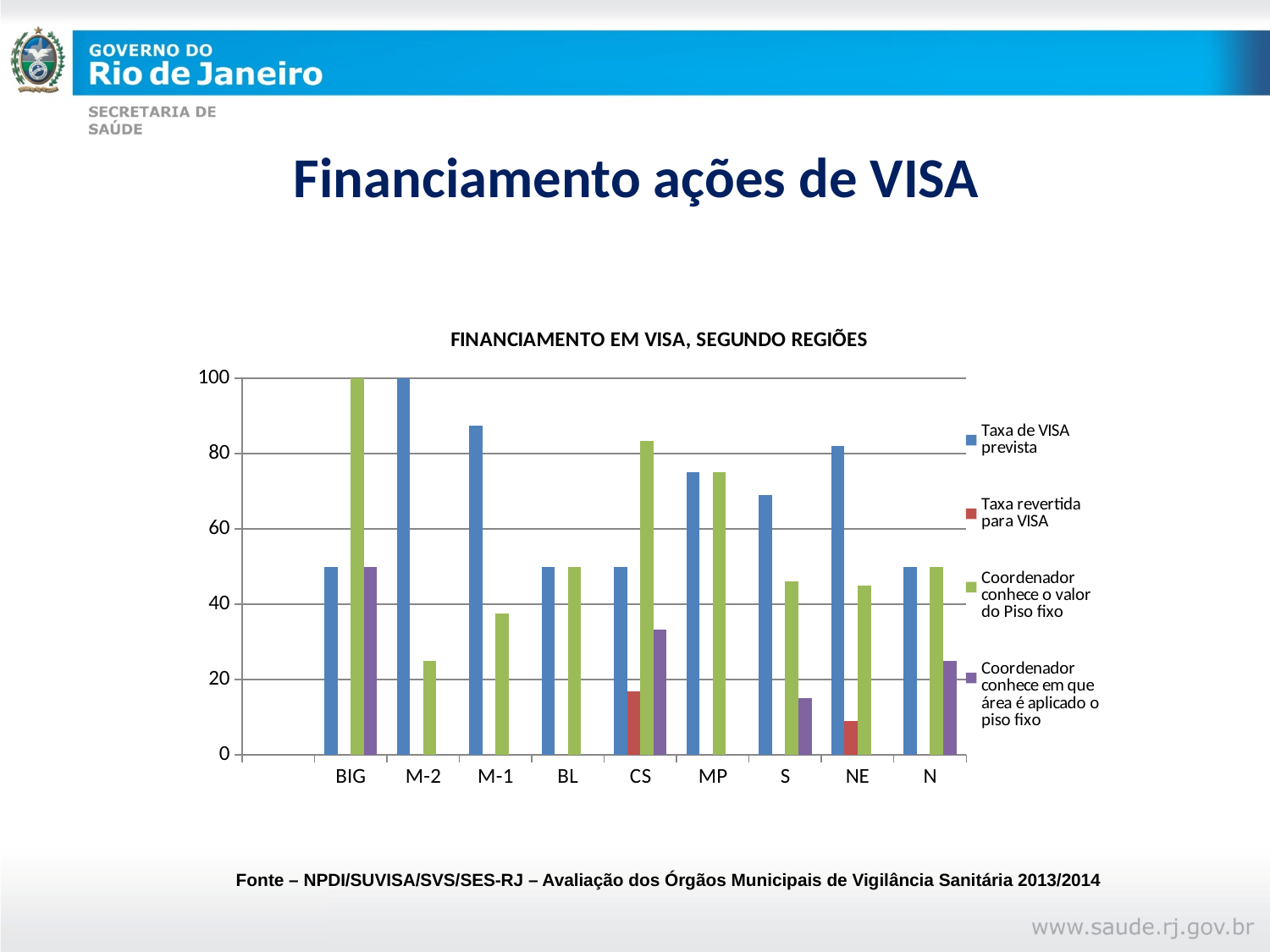
Which region has the highest value for 'Taxa de VISA prevista'? M-2 How many regions have a bar for 'Taxa revertida para VISA'? 2 What kind of chart is shown on the slide? bar chart Which region has the highest value for 'Coordenador conhece o valor do Piso fixo'? BIG For M-1, which is larger: 'Taxa de VISA prevista' or 'Coordenador conhece o valor do Piso fixo'? Taxa de VISA prevista How many regions (categories) are shown on the x axis of the chart? 9 How many series does the chart legend list? 4 What is the value of 'Coordenador conhece o valor do Piso fixo' for BIG? 100 Is the value of 'Taxa de VISA prevista' for M-1 greater or less than 80? greater What is the value of 'Taxa de VISA prevista' for M-2? 100 Is the value of 'Taxa revertida para VISA' for NE greater or less than 20? less What is the title of the chart? FINANCIAMENTO EM VISA, SEGUNDO REGIÕES